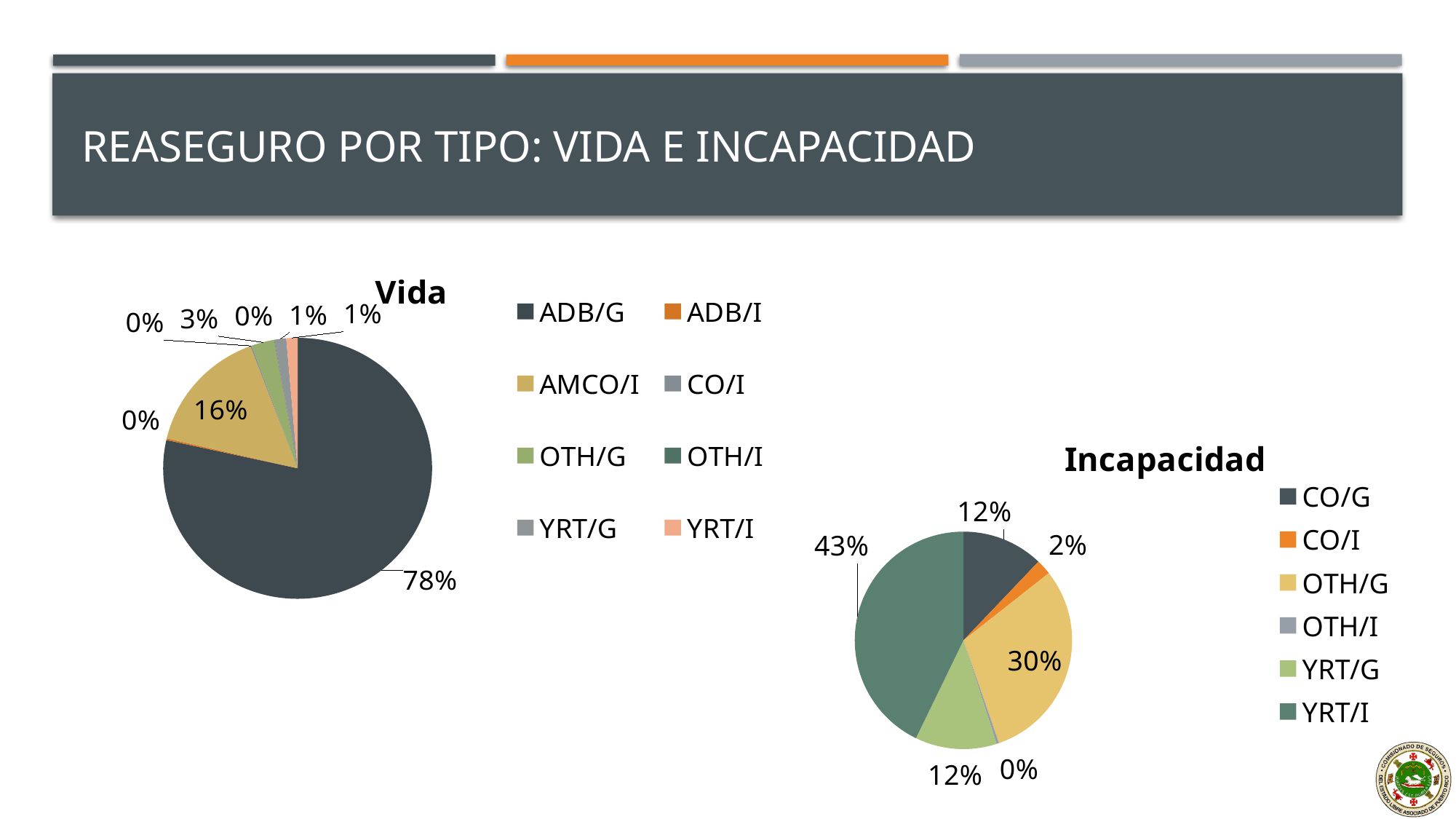
In the Incapacidad chart, which is larger, CO/G or OTH/G? OTH/G In the Vida chart, what share does ADB/G have? 78% How many series does the legend of the Vida chart list? 8 In the Vida chart, which category has the largest slice? ADB/G In the Vida chart, what share does OTH/G have? 3% In the Incapacidad chart, what share does CO/I have? 2% In the Incapacidad chart, what is the difference between the YRT/I share and the OTH/G share? 13% What kind of chart is the Incapacidad chart? Pie chart In the Incapacidad chart, which category has the largest slice? YRT/I